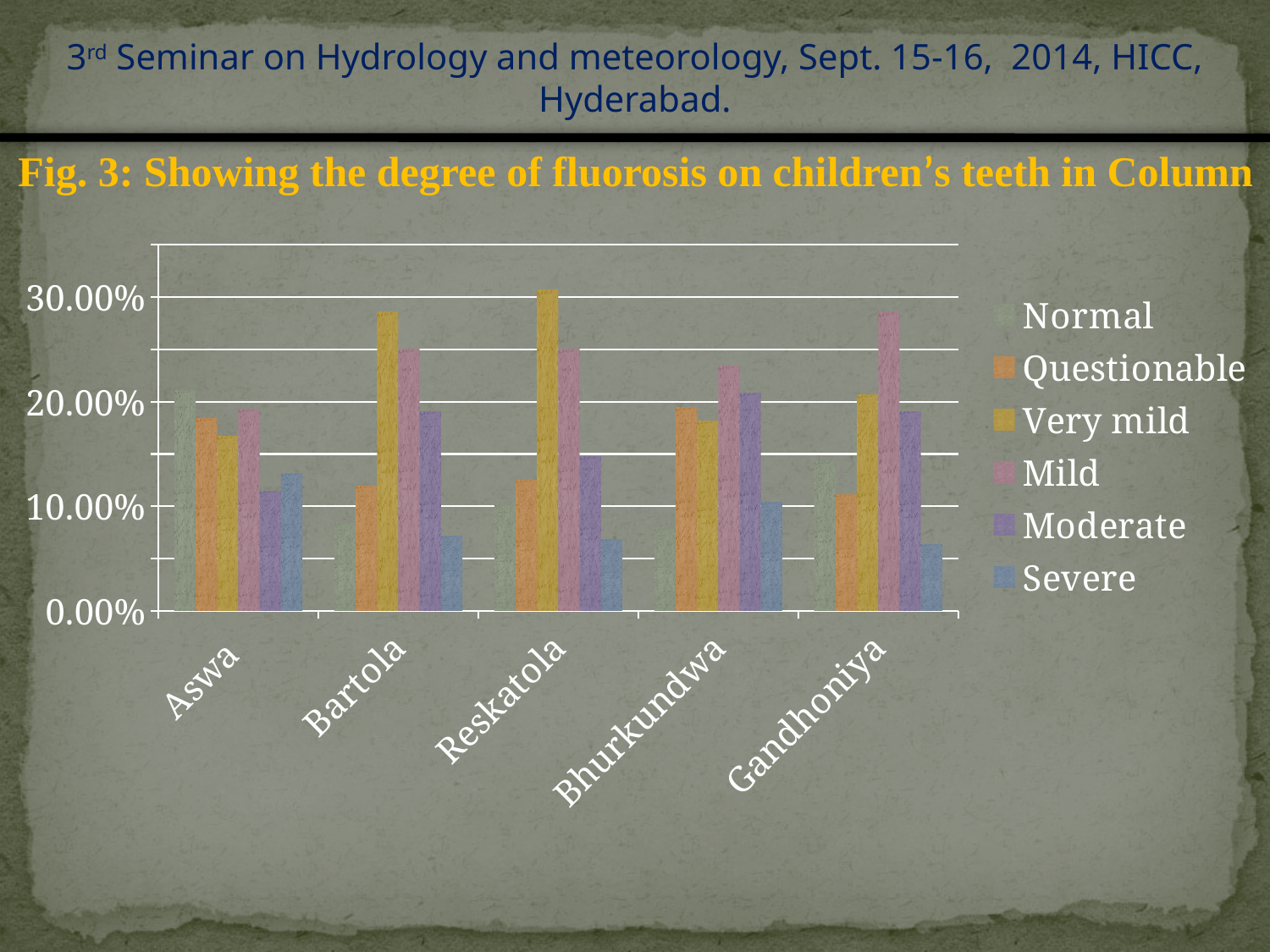
Which village has the highest Very mild value? Reskatola Which village has the highest Normal value? Aswa For Bartola, which is larger, the Very mild value or the Severe value? Very mild Is the Normal value for Aswa greater or less than 20.00%? greater How many series does the chart's legend list? 6 What kind of chart is shown on the slide? bar chart Is the Mild value for Gandhoniya greater or less than 20.00%? greater Is the Severe value for Bartola greater or less than 10.00%? less Which is larger, the Normal value for Aswa or the Normal value for Bartola? Aswa Which series is listed last in the chart's legend? Severe How many villages (categories) are shown on the x axis of the chart? 5